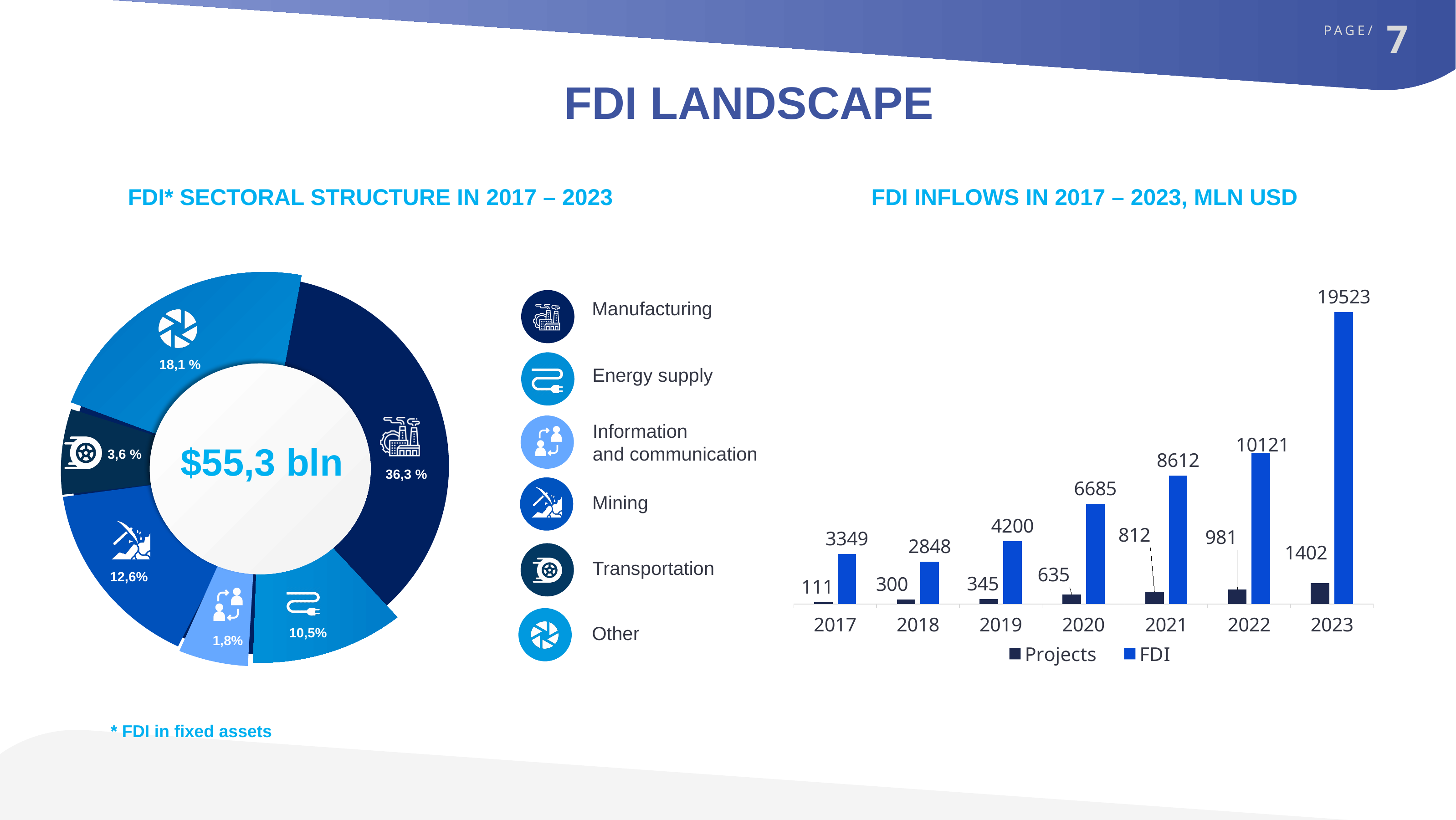
In the FDI INFLOWS IN 2017 – 2023, MLN USD chart, do the Projects values rise or fall from 2017 to 2023? rise In the FDI* SECTORAL STRUCTURE IN 2017 – 2023 chart, which sector has the smallest share? Information and communication In the FDI INFLOWS IN 2017 – 2023, MLN USD chart, what is the difference between the FDI values for 2023 and 2022? 9402 What kind of chart is the FDI INFLOWS IN 2017 – 2023, MLN USD chart? bar chart In the FDI INFLOWS IN 2017 – 2023, MLN USD chart, how many series does the legend list? 2 In the FDI INFLOWS IN 2017 – 2023, MLN USD chart, which year has the lowest FDI value? 2018 In the FDI INFLOWS IN 2017 – 2023, MLN USD chart, what is the FDI value for 2023? 19523 In the FDI INFLOWS IN 2017 – 2023, MLN USD chart, is the FDI value larger in 2017 or 2018? 2017 In the FDI* SECTORAL STRUCTURE IN 2017 – 2023 chart, what share does Manufacturing have? 36,3 % In the FDI INFLOWS IN 2017 – 2023, MLN USD chart, how many years are shown on the x axis? 7 In the FDI INFLOWS IN 2017 – 2023, MLN USD chart, what is the Projects value for 2019? 345 In the FDI INFLOWS IN 2017 – 2023, MLN USD chart, which year has the highest Projects value? 2023